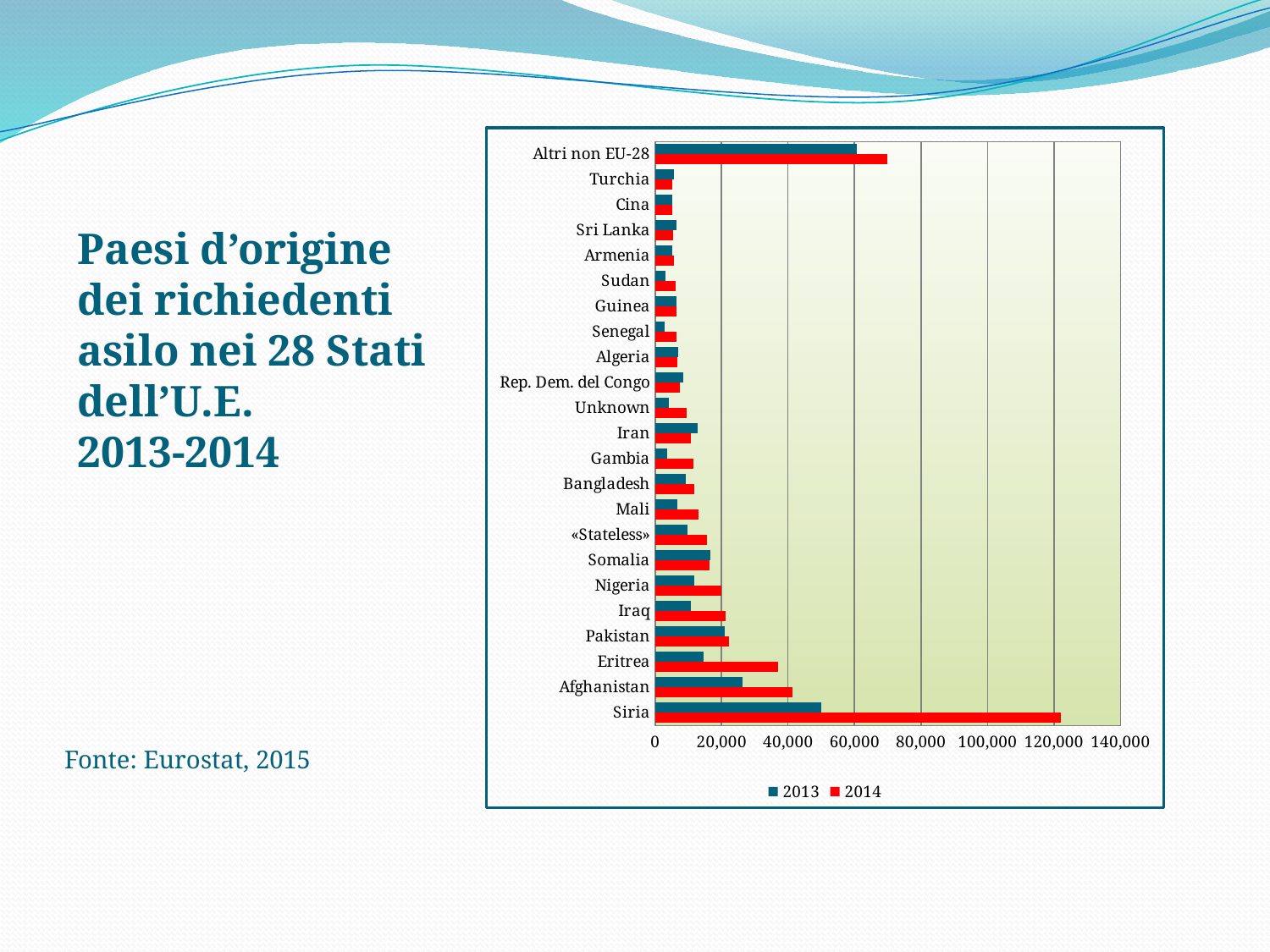
How many series does the chart legend list? 2 Is the 2014 value for Altri non EU-28 greater or less than 60,000? greater Is the 2014 value for Siria greater or less than 100,000? greater Which is larger for Eritrea, the 2013 value or the 2014 value? 2014 Is the 2014 value for Eritrea greater or less than 40,000? less Which colour represents the 2014 series in the chart? red Which category has the highest value for 2014? Siria Which has the larger 2014 value, Siria or Afghanistan? Siria What kind of chart is shown on the slide? bar chart Which category has the highest value for 2013? Altri non EU-28 How many countries/categories are plotted on the chart? 23